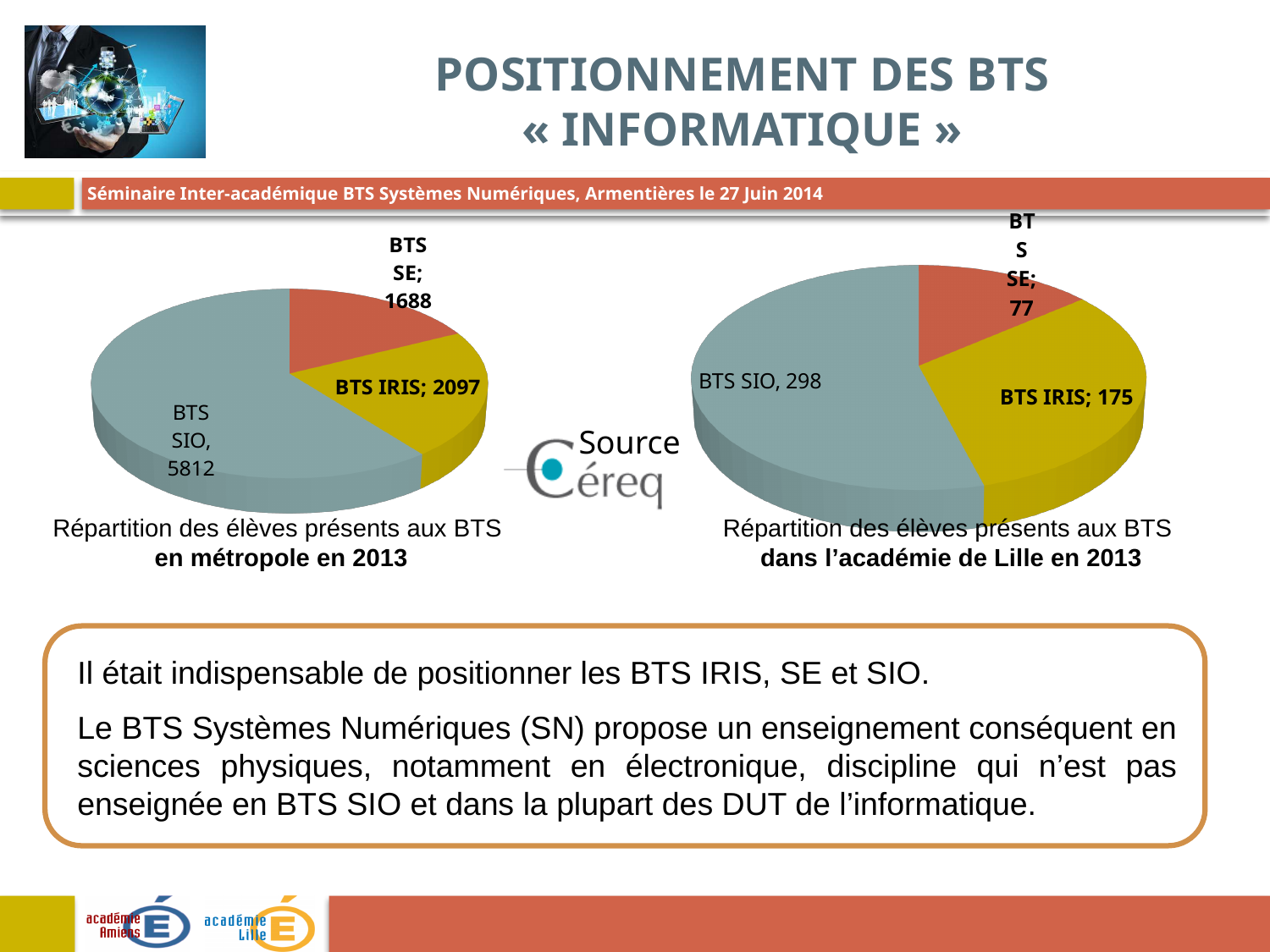
In the right pie chart (académie de Lille en 2013), how many students are in BTS IRIS? 175 In the left pie chart (en métropole en 2013), what is the difference between BTS IRIS and BTS SE? 409 In the left pie chart (en métropole en 2013), which BTS has the largest slice? BTS SIO How many slices does the left pie chart (en métropole en 2013) have? 3 In the left pie chart (en métropole en 2013), what is the value for BTS IRIS? 2097 In the right pie chart (académie de Lille en 2013), which BTS has the smallest slice? BTS SE What is the total number of students across all three slices in the right pie chart (académie de Lille en 2013)? 550 What type of chart is used on the right side of the slide (académie de Lille en 2013)? Pie chart In the left pie chart (en métropole en 2013), how many students are in BTS SIO? 5812 In the right pie chart (académie de Lille en 2013), what is the value for BTS SE? 77 In the right pie chart (académie de Lille en 2013), what is the difference between BTS SIO and BTS IRIS? 123 In the right pie chart (académie de Lille en 2013), which is larger, BTS IRIS or BTS SE? BTS IRIS